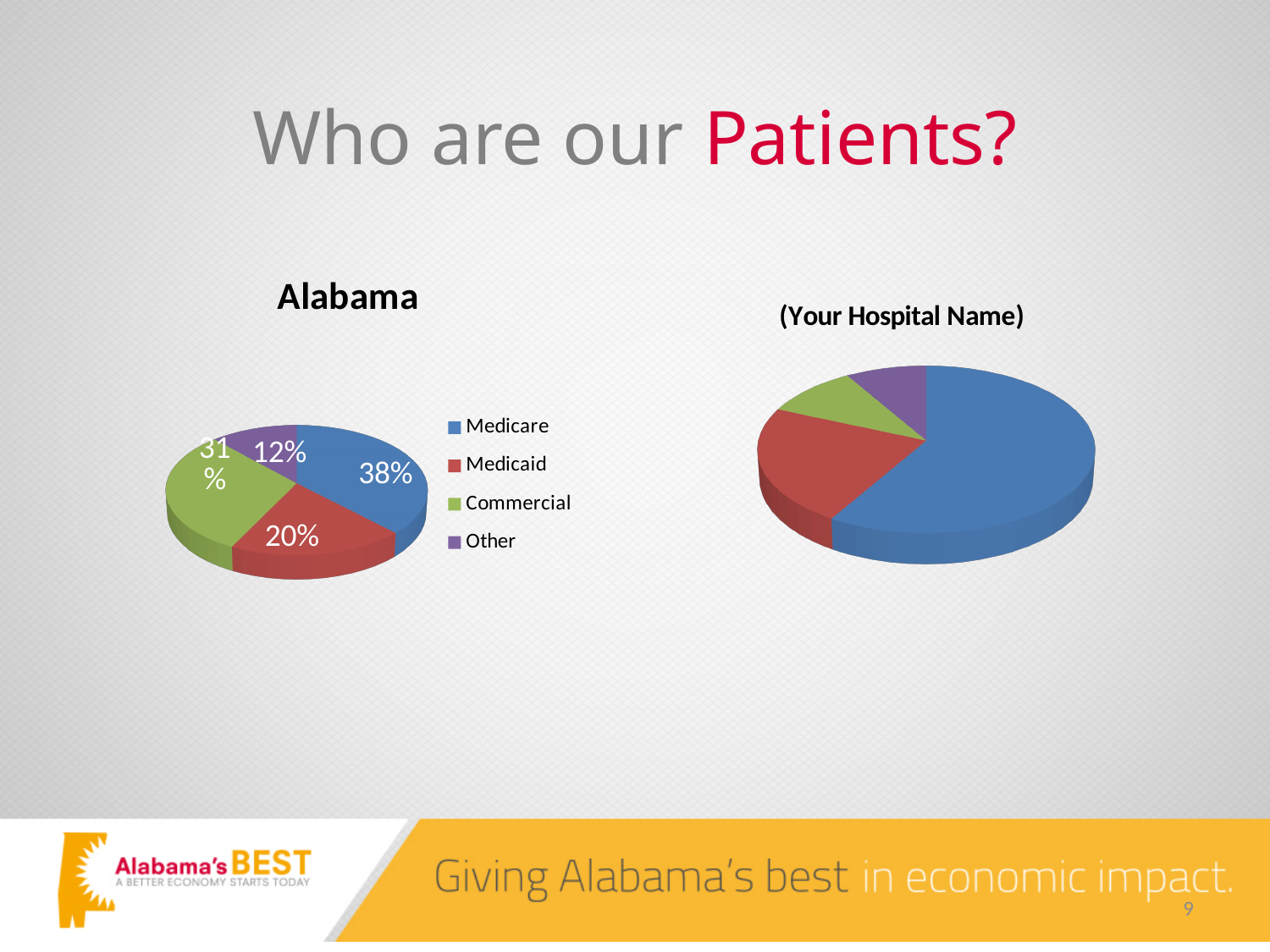
In the Alabama chart, which category has the largest share? Medicare What kind of chart is the Alabama chart? Pie chart In the Alabama chart, what share of patients is Other? 12% In the Alabama chart, which category has the smallest share? Other In the Alabama chart, which is larger, the Commercial share or the Medicaid share? Commercial In the Alabama chart, what colour represents Commercial in the legend? Green How many categories does the legend of the Alabama chart list? 4 In the Alabama chart, what share of patients is Medicaid? 20% In the Alabama chart, what share of patients is Medicare? 38% How many slices does the (Your Hospital Name) chart have? 4 In the Alabama chart, what share of patients is Commercial? 31% In the Alabama chart, what is the difference between the Medicare and Medicaid shares? 18%